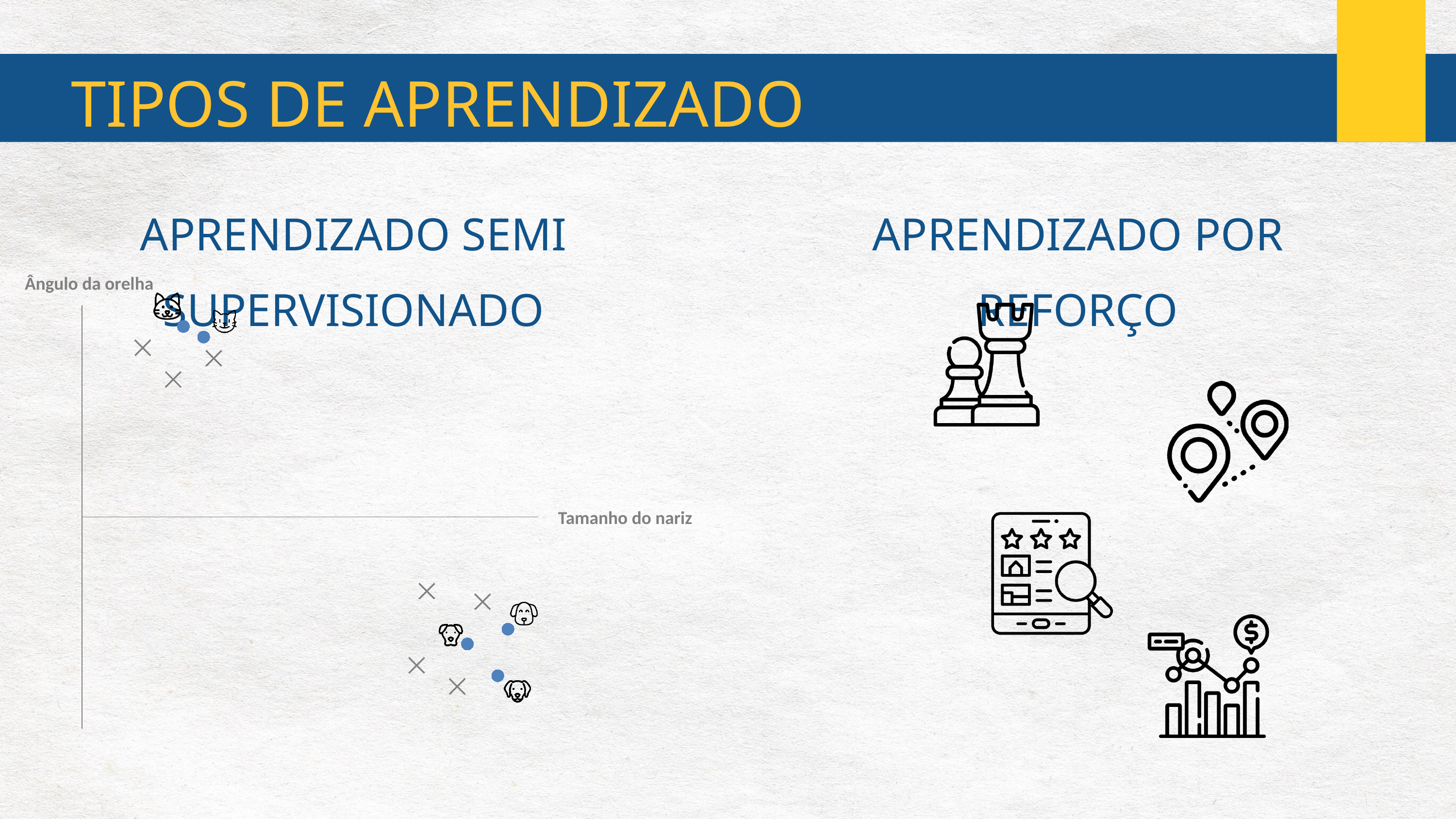
How many X markers are in the lower-right (dog) cluster of the scatter chart? 4 What kind of chart is shown on the left side of the slide under 'Aprendizado semi supervisionado'? Scatter chart How many blue dot markers are plotted in the scatter chart in total? 5 Which cluster in the scatter chart has the larger values on the 'Tamanho do nariz' axis, the cat cluster or the dog cluster? Dog cluster In the scatter chart, as 'Tamanho do nariz' increases, does 'Ângulo da orelha' rise or fall? Fall What is the label of the vertical axis of the scatter chart? Ângulo da orelha How many blue dot markers are in the upper-left (cat) cluster of the scatter chart? 2 What is the label of the horizontal axis of the scatter chart? Tamanho do nariz Which cluster in the scatter chart has the higher values on the 'Ângulo da orelha' axis, the cat cluster or the dog cluster? Cat cluster